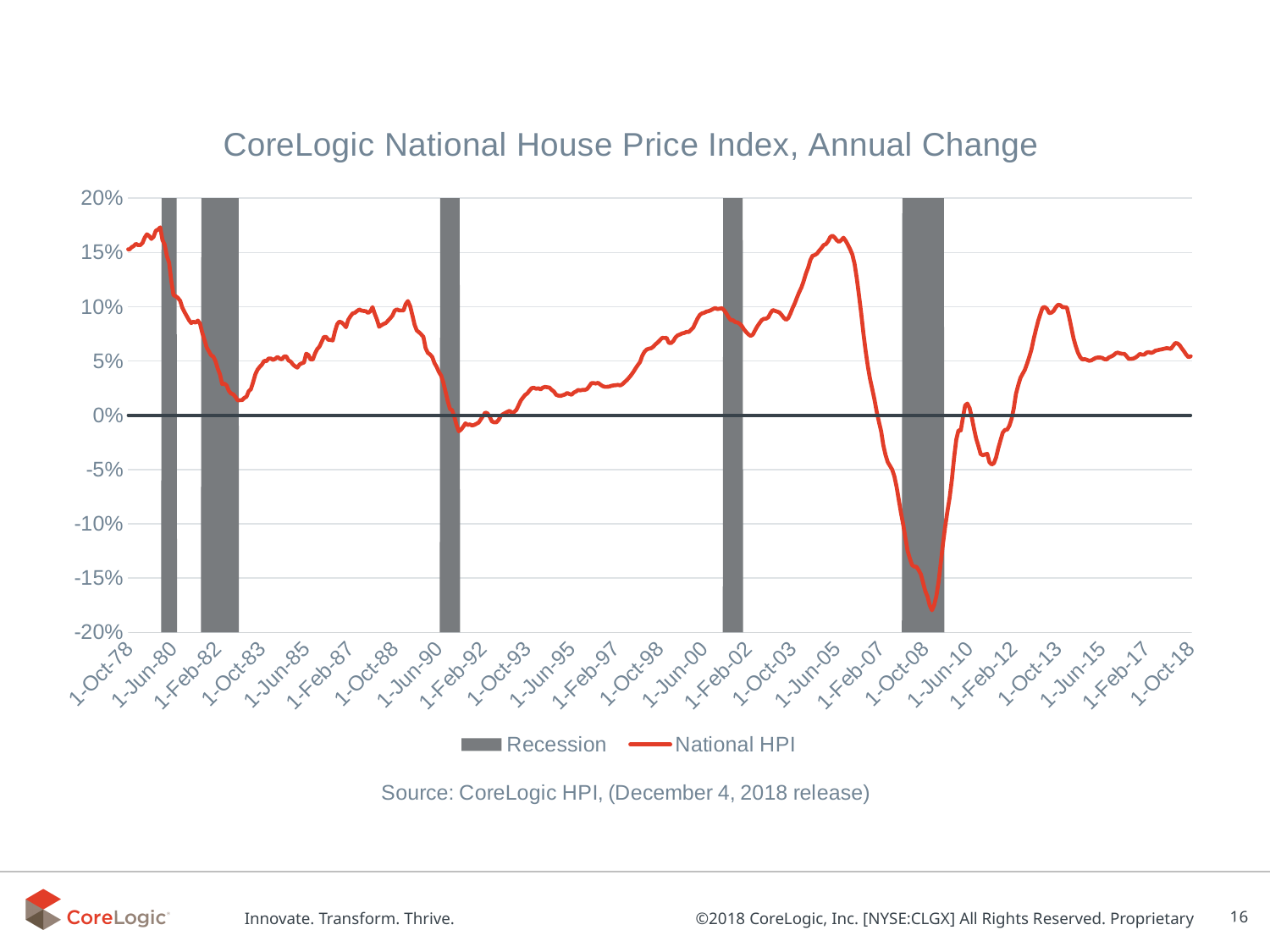
Is the National HPI value at 1-Jun-05 greater or less than 10%? greater Is the National HPI value at 1-Oct-78 greater or less than 10%? greater Is the National HPI value at 1-Oct-18 greater or less than 10%? less Does the National HPI line rise or fall between 1-Jun-05 and 1-Oct-08? fall What kind of chart is shown on the slide? line chart Does the National HPI line rise or fall between 1-Oct-08 and 1-Oct-13? rise How many entries does the chart legend list? 2 How many shaded recession bars are shown on the chart? 5 What is the highest value shown on the vertical axis? 20% What are the two entries in the chart legend? Recession and National HPI What is the title of the chart? CoreLogic National House Price Index, Annual Change